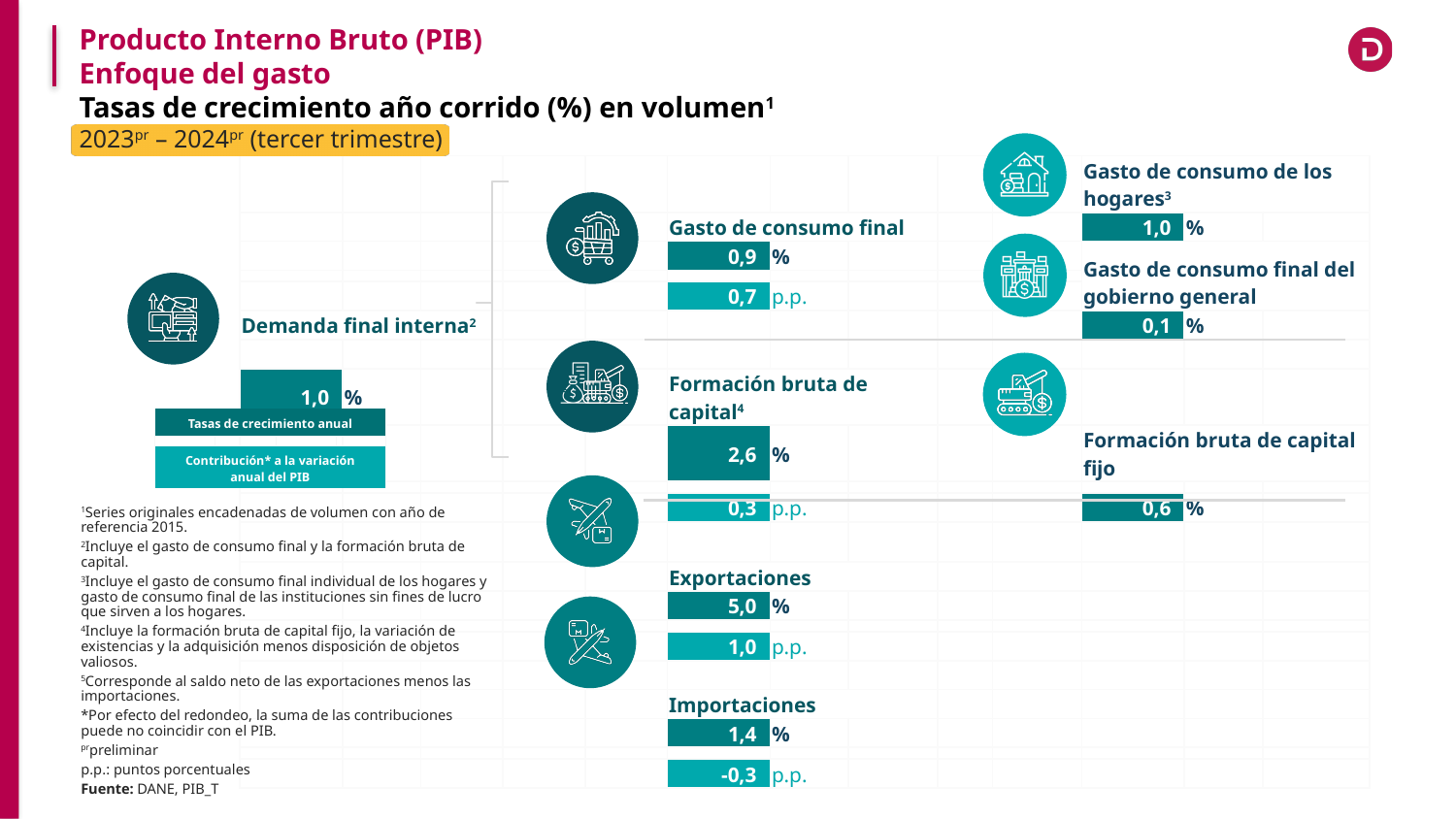
What is the contribution to the annual variation of GDP (p.p.) shown for Gasto de consumo final? 0,7 p.p. What do the two colours of bars represent according to the legend? Tasas de crecimiento anual and Contribución* a la variación anual del PIB Which has a larger annual growth rate, Formación bruta de capital or Formación bruta de capital fijo? Formación bruta de capital What is the annual growth rate shown for Gasto de consumo final del gobierno general? 0,1 % What is the annual growth rate shown for Gasto de consumo final? 0,9 % Which component shows the lowest annual growth rate on the slide? Gasto de consumo final del gobierno general What is the difference between the annual growth rates of Gasto de consumo de los hogares and Gasto de consumo final del gobierno general? 0,9 percentage points What is the difference between the annual growth rates of Exportaciones and Importaciones? 3,6 percentage points What is the annual growth rate shown for Formación bruta de capital? 2,6 % What is the contribution in p.p. shown for Importaciones? -0,3 p.p. Which component shows the highest annual growth rate on the slide? Exportaciones What is the annual growth rate (Tasas de crecimiento anual) shown for Demanda final interna? 1,0 %